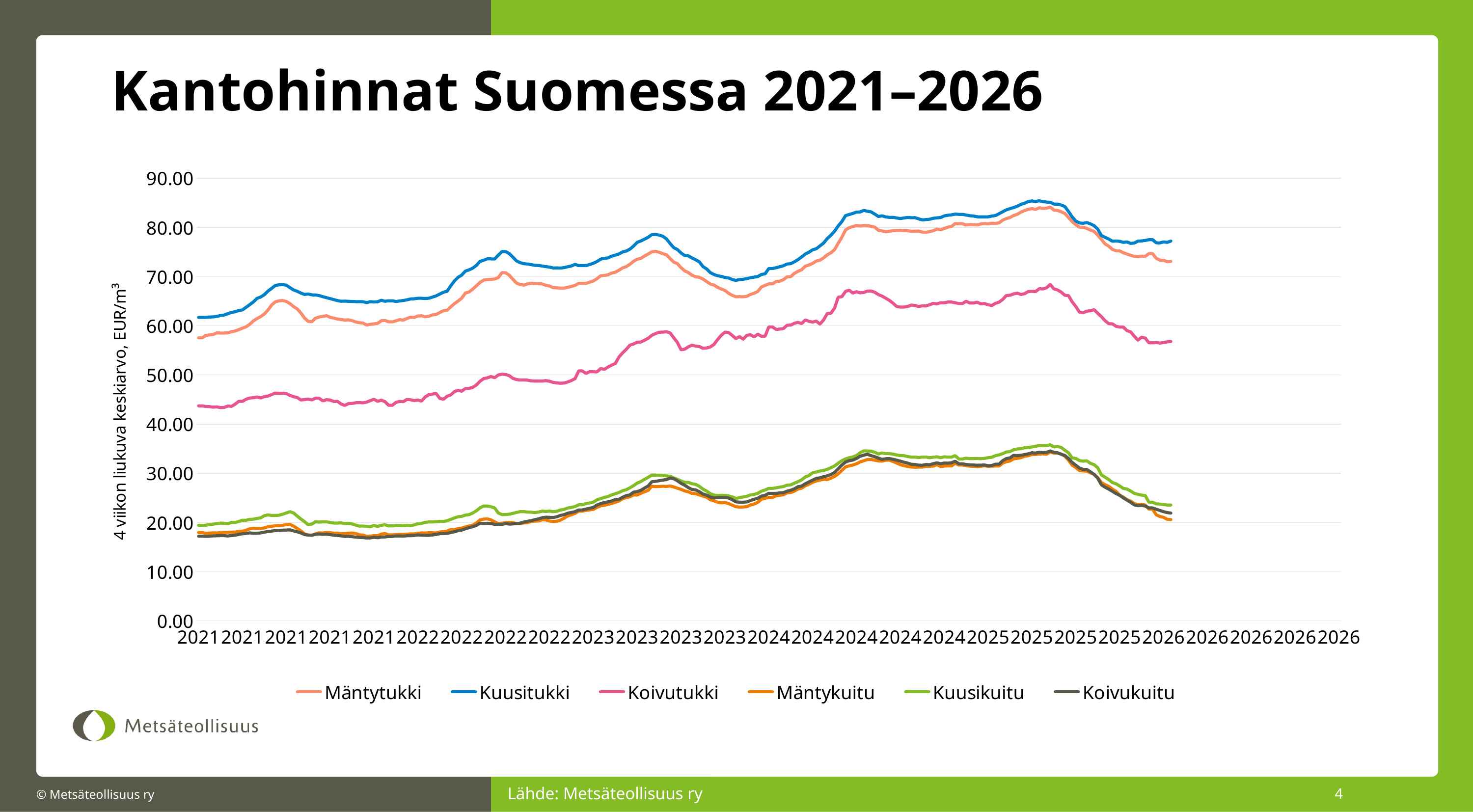
What kind of chart is shown on the slide? line chart Which series has larger values, Mäntytukki or Kuusikuitu? Mäntytukki Does the Koivutukki series generally rise or fall from 2021 to 2025? rise Which series has the highest values across the whole period? Kuusitukki Which series has larger values, Kuusitukki or Koivutukki? Kuusitukki Is the highest value reached by Kuusikuitu greater or less than 40? less What is the title of the chart on the slide? Kantohinnat Suomessa 2021–2026 What is the label of the vertical axis? 4 viikon liukuva keskiarvo, EUR/m³ Is the peak value of Kuusitukki greater or less than 80? greater Is the value of Mäntytukki at the start of 2021 greater or less than 60? less How many series does the legend list? 6